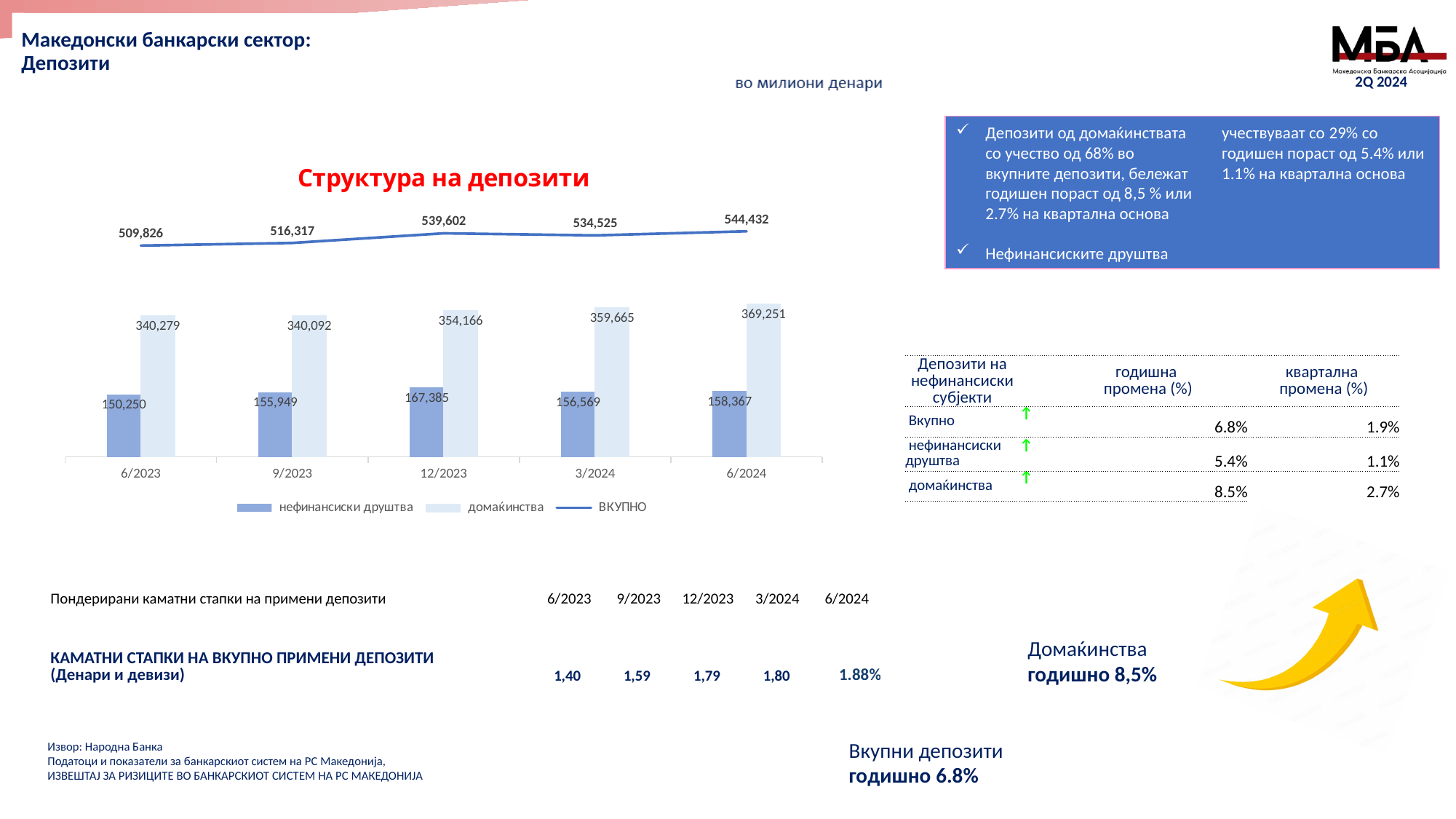
How many series does the legend of the chart 'Структура на депозити' list? 3 In the chart 'Структура на депозити', what is the difference between домаќинства and нефинансиски друштва in 6/2024? 210,884 In the chart 'Структура на депозити', in which period is the ВКУПНО value lowest? 6/2023 In the chart 'Структура на депозити', which is larger in 3/2024: домаќинства or нефинансиски друштва? домаќинства In the chart 'Структура на депозити', does the ВКУПНО value overall rise or fall from 6/2023 to 6/2024? rise How many time periods are shown on the x axis of the chart 'Структура на депозити'? 5 In the chart 'Структура на депозити', in which period is the value for нефинансиски друштва highest? 12/2023 In the chart 'Структура на депозити', what is the value for нефинансиски друштва in 6/2024? 158,367 What kind of chart is 'Структура на депозити'? Bar chart with a line In the chart 'Структура на депозити', what is the value for домаќинства in 12/2023? 354,166 In the chart 'Структура на депозити', by how much did the ВКУПНО value change from 6/2023 to 6/2024? 34,606 In the chart 'Структура на депозити', what is the ВКУПНО value for 6/2023? 509,826